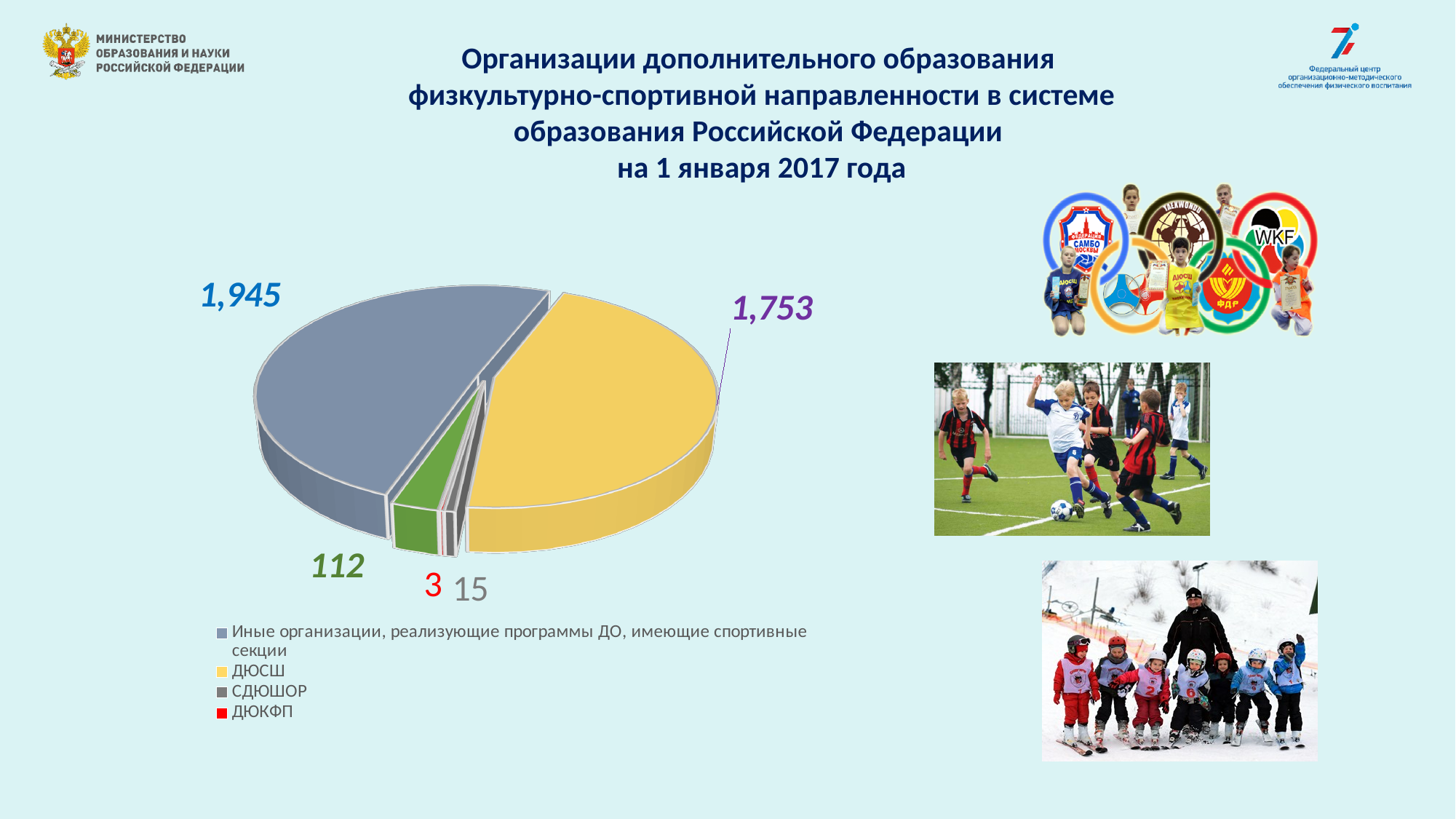
What is the difference between the value for 'Иные организации' (1,945) and the value for ДЮСШ (1,753)? 192 What value is labelled on the green slice of the pie chart? 112 What value is shown for СДЮШОР in the pie chart? 15 Which category has the largest slice in the pie chart? Иные организации, реализующие программы ДО, имеющие спортивные секции What kind of chart is shown on the slide? pie chart Which legend category has the smallest value in the pie chart? ДЮКФП How many slices with data labels does the pie chart have? 5 Which is larger, the value for ДЮСШ or the value for СДЮШОР? ДЮСШ How many entries does the legend of the pie chart list? 4 What value is shown for ДЮСШ in the pie chart? 1,753 What value is shown for 'Иные организации, реализующие программы ДО, имеющие спортивные секции'? 1,945 What value is shown for ДЮКФП in the pie chart? 3